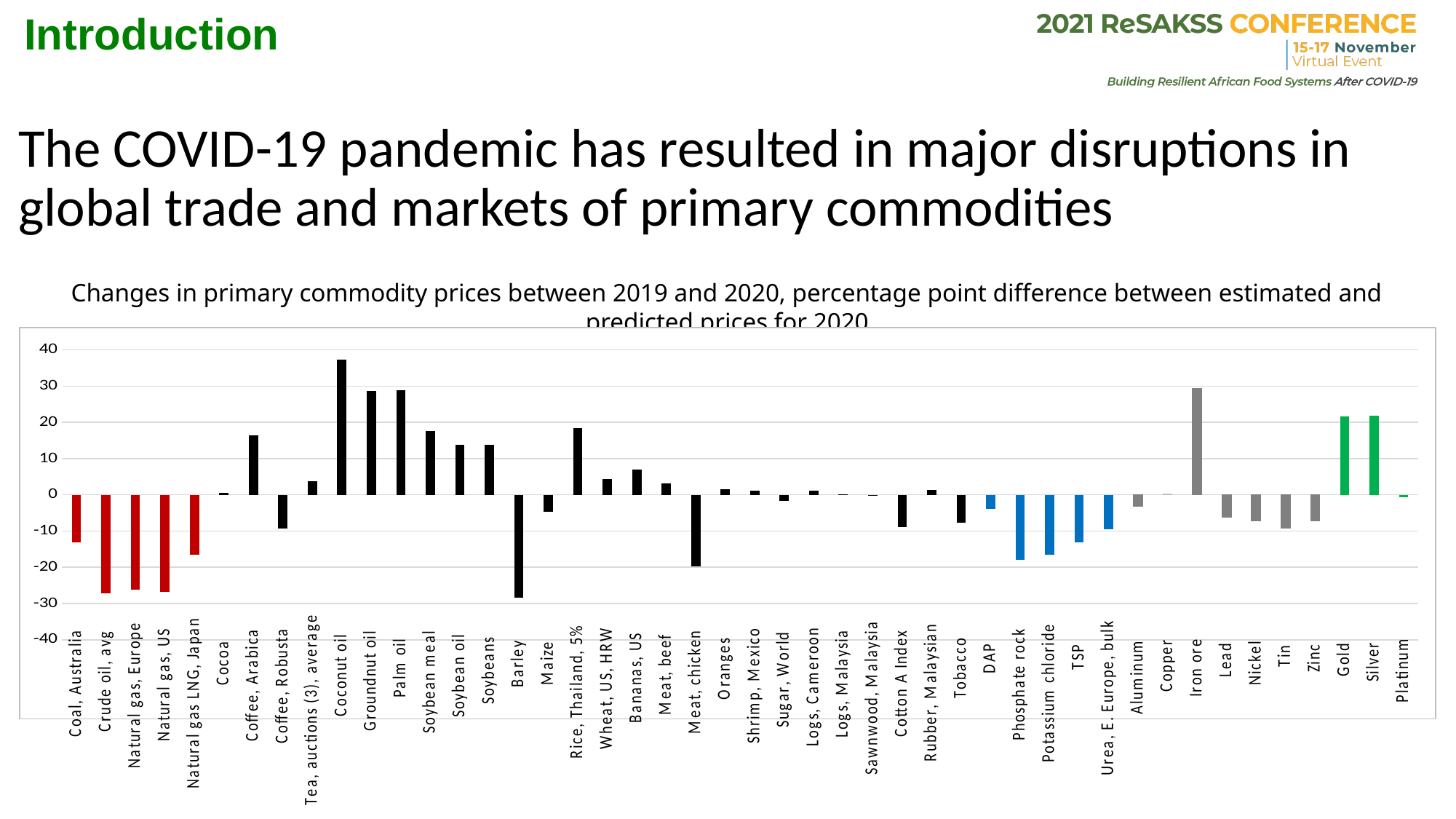
Is the value for Barley greater or less than -20? less Which has the larger value, Groundnut oil or Coffee, Arabica? Groundnut oil Which has the larger value, Coconut oil or Iron ore? Coconut oil What kind of chart is shown on the slide? bar chart What colour are the bars for Gold and Silver? green Which commodity has the highest value on the chart? Coconut oil Which has the lower value, Phosphate rock or DAP? Phosphate rock Is the value for Coconut oil greater or less than 30? greater Is the value for Iron ore greater or less than 20? greater How many commodities are plotted on the chart? 46